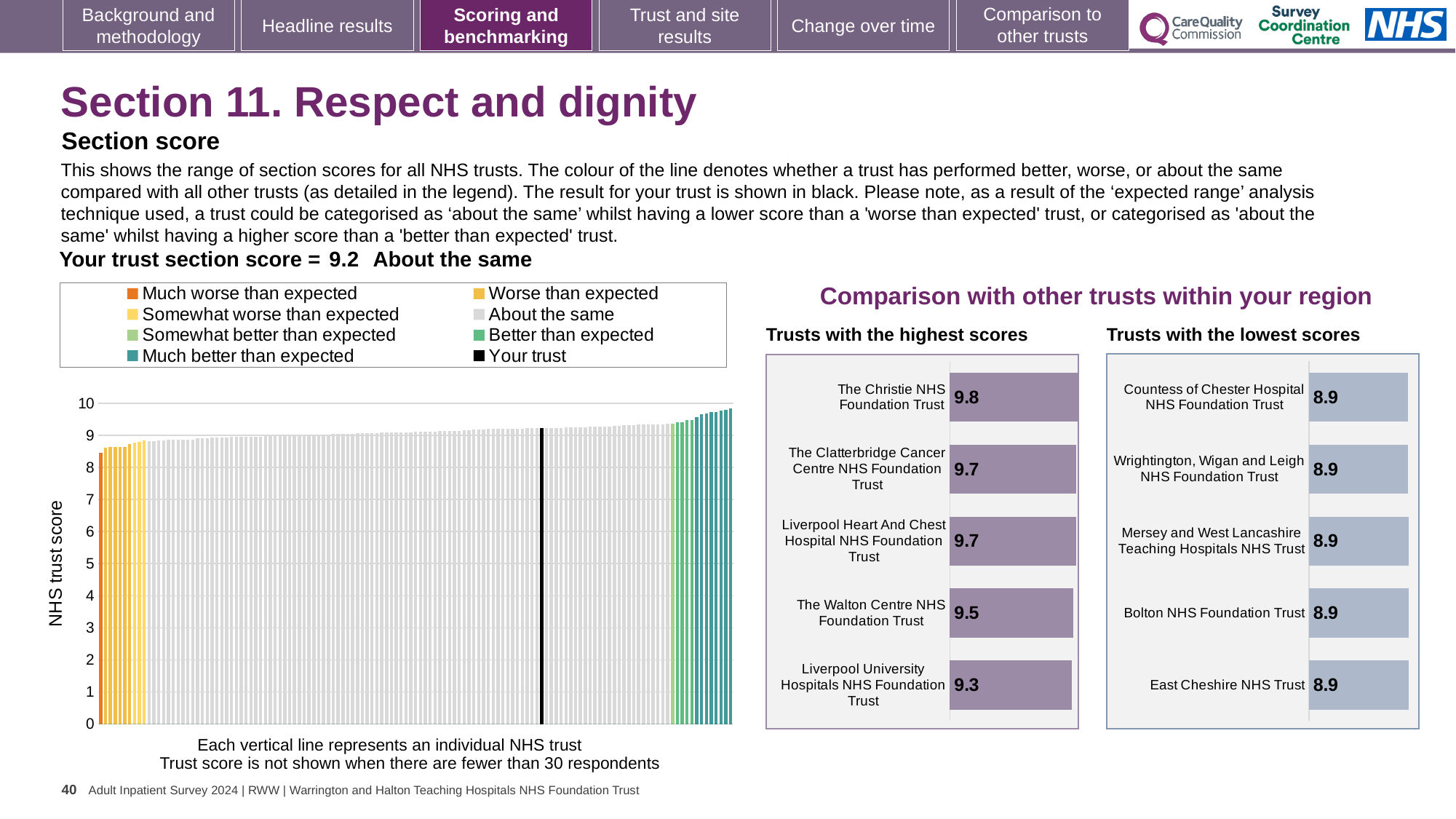
In the 'Trusts with the highest scores' chart, what is the score for The Walton Centre NHS Foundation Trust? 9.5 In the 'Trusts with the highest scores' chart, which has the larger score: The Clatterbridge Cancer Centre NHS Foundation Trust or The Walton Centre NHS Foundation Trust? The Clatterbridge Cancer Centre NHS Foundation Trust In the 'Trusts with the highest scores' chart, what is the difference between the scores of The Christie NHS Foundation Trust and Liverpool University Hospitals NHS Foundation Trust? 0.5 How many trusts are listed in the 'Trusts with the lowest scores' chart? 5 In the 'Trusts with the highest scores' chart, what is the score for The Christie NHS Foundation Trust? 9.8 What kind of chart is the large chart on the left showing NHS trust scores? Bar chart In the 'Trusts with the lowest scores' chart, what is the score for Bolton NHS Foundation Trust? 8.9 How many trusts are listed in the 'Trusts with the highest scores' chart? 5 In the 'Trusts with the highest scores' chart, which trust has the highest score? The Christie NHS Foundation Trust In the 'Trusts with the highest scores' chart, which trust has the lowest score? Liverpool University Hospitals NHS Foundation Trust In the large chart on the left, how many entries does the legend list? 8 In the large chart on the left, what is the label on the vertical axis? NHS trust score